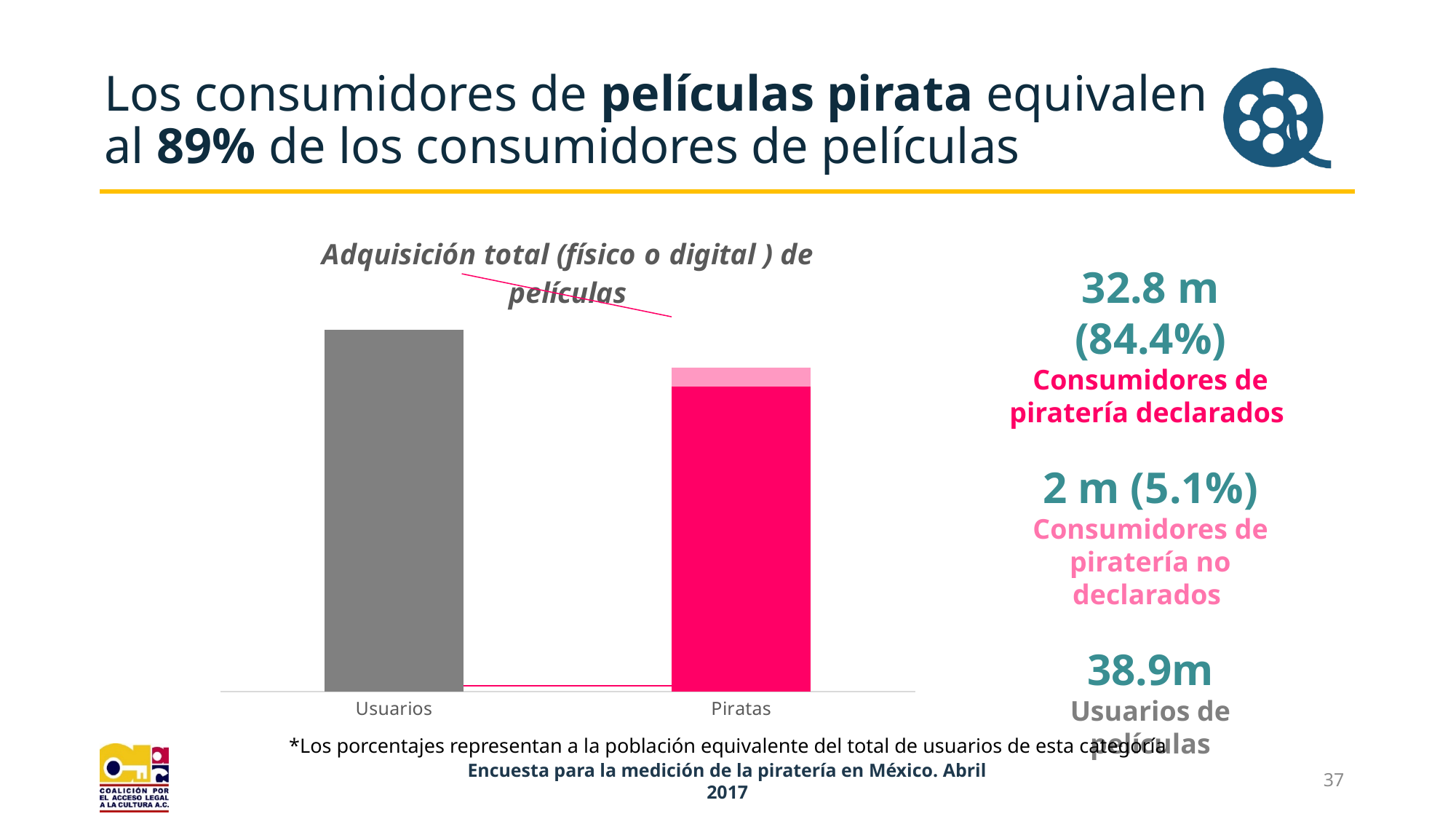
What kind of chart is shown on the slide? bar chart What is the title of the chart? Adquisición total (físico o digital ) de películas In the Piratas bar, which segment is larger: the dark pink (declared) or the light pink (undeclared) segment? dark pink (declared) Which category has the taller bar, Usuarios or Piratas? Usuarios According to the annotation on the slide, how many declared piracy consumers (Consumidores de piratería declarados) are there? 32.8 m Which category has the lowest bar in the chart? Piratas How many categories are shown on the x axis of the chart? 2 According to the annotation on the slide, what percentage do the undeclared piracy consumers (Consumidores de piratería no declarados) represent? 5.1% Which category has the highest bar in the chart? Usuarios According to the annotation on the slide, how many users of films (Usuarios de películas) are there? 38.9m What are the two category labels on the x axis of the chart? Usuarios, Piratas Do the bar heights rise or fall from Usuarios to Piratas? fall